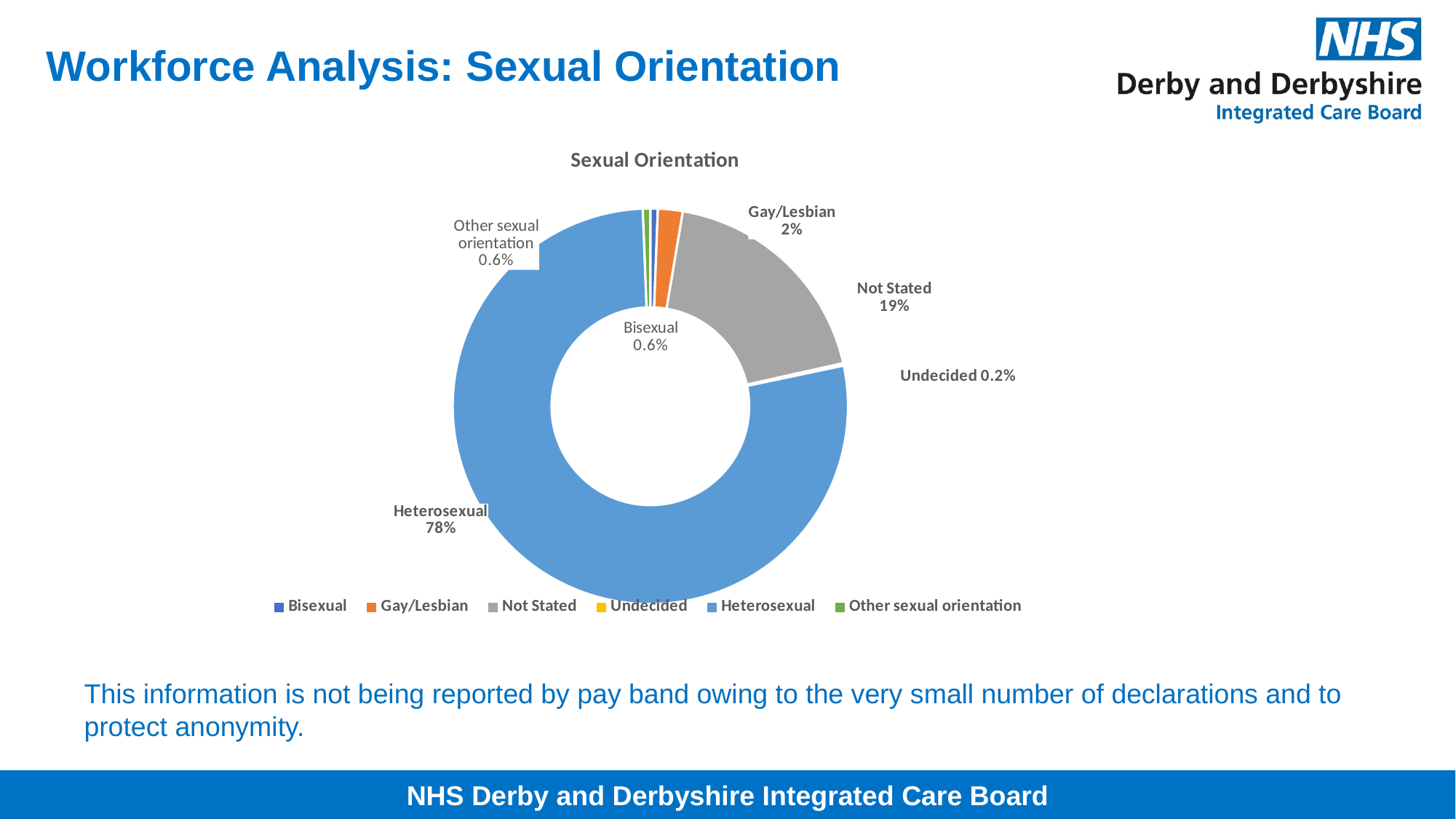
What percentage is shown for Undecided in the Sexual Orientation chart? 0.2% What percentage is shown for Bisexual in the Sexual Orientation chart? 0.6% What percentage is shown for Gay/Lesbian in the Sexual Orientation chart? 2% Which category has the largest share in the Sexual Orientation chart? Heterosexual What percentage is shown for Not Stated in the Sexual Orientation chart? 19% What is the difference in percentage points between Heterosexual and Not Stated in the Sexual Orientation chart? 59 What colour represents Not Stated in the Sexual Orientation chart? Grey How many categories does the legend of the Sexual Orientation chart list? 6 What kind of chart is used to show Sexual Orientation on this slide? Doughnut (pie) chart Which category has the smallest share in the Sexual Orientation chart? Undecided Which is larger in the Sexual Orientation chart, Gay/Lesbian or Bisexual? Gay/Lesbian What percentage of the workforce is shown as Heterosexual in the Sexual Orientation chart? 78%